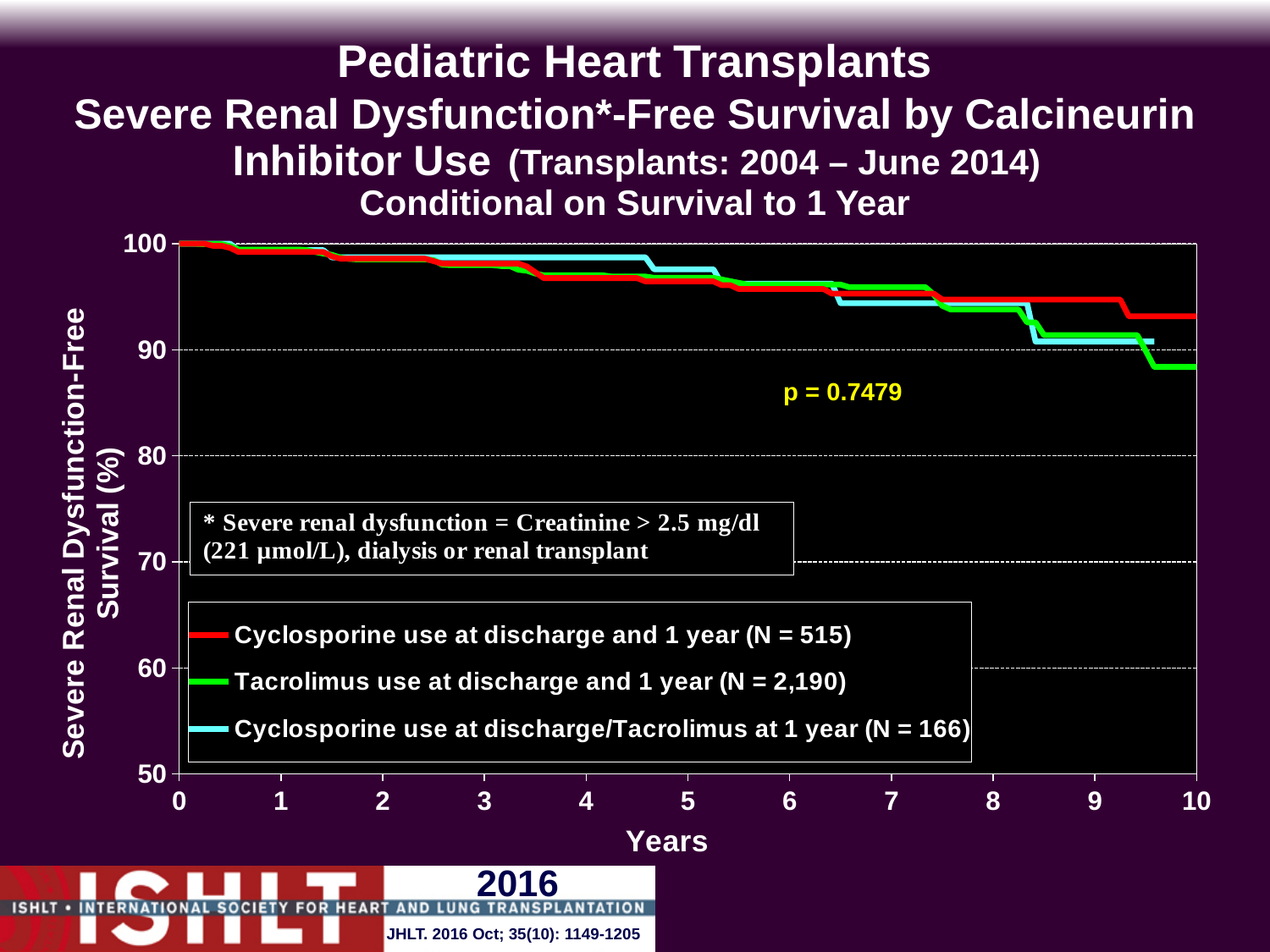
What is the N for the Tacrolimus use at discharge and 1 year group in the legend? 2,190 Is the value for the Cyclosporine use at discharge/Tacrolimus at 1 year curve at 8 years greater or less than 90? greater Which group has the highest survival at 9 years? Cyclosporine use at discharge and 1 year At 10 years, which curve is higher: Cyclosporine use at discharge and 1 year or Tacrolimus use at discharge and 1 year? Cyclosporine use at discharge and 1 year What is the p-value shown on the chart? p = 0.7479 What kind of chart is shown on the slide? line chart Do the survival curves rise or fall as years increase? fall Is the value for the Cyclosporine use at discharge and 1 year curve at 10 years greater or less than 90? greater How many series does the legend list? 3 Is the value for the Tacrolimus use at discharge and 1 year curve at 10 years greater or less than 90? less What is the maximum value shown on the x axis? 10